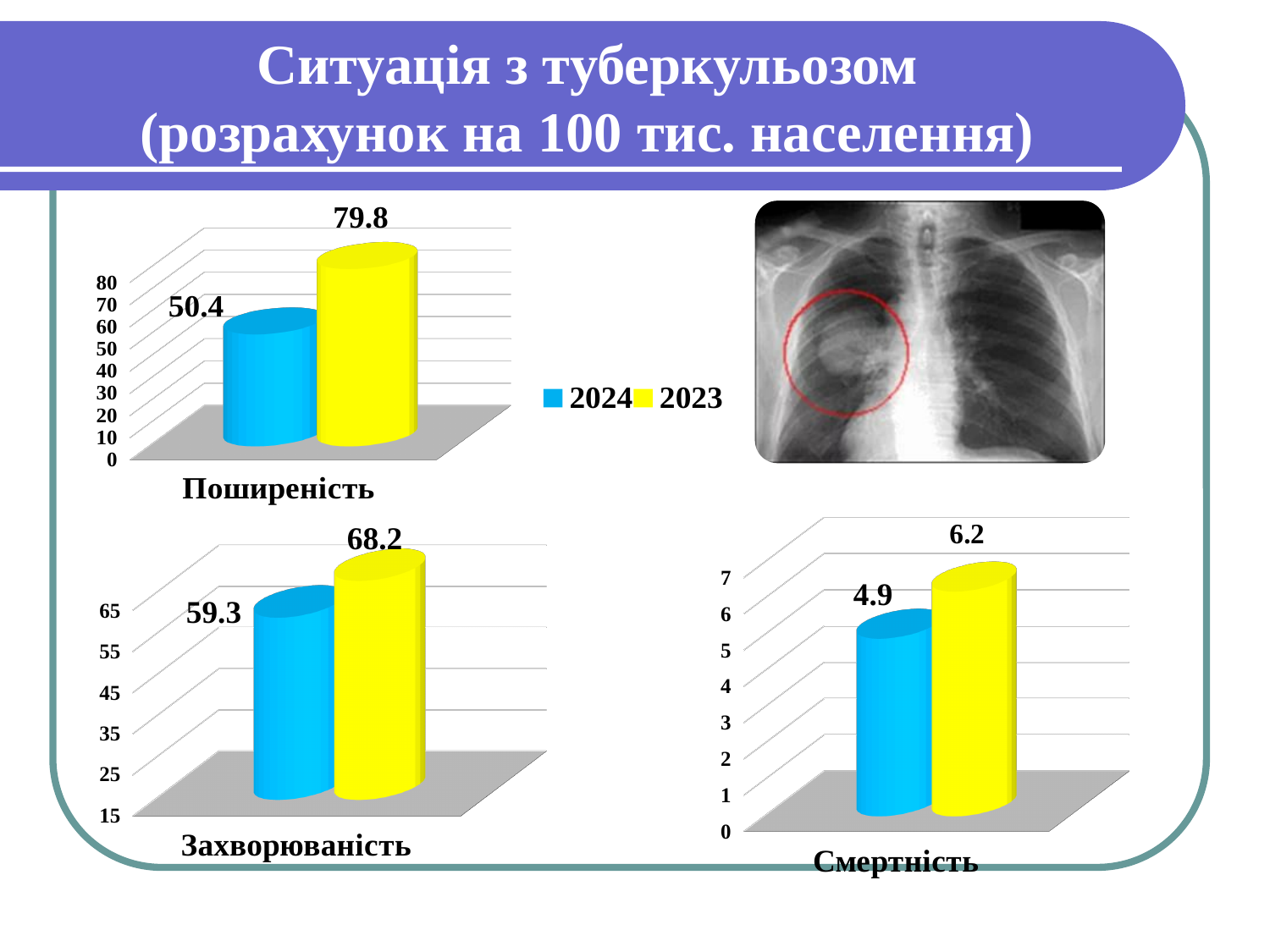
In the Захворюваність chart, what is the value for 2023? 68.2 In the Захворюваність chart, which year has the lower value? 2024 In the Смертність chart, which year has the higher value, 2024 or 2023? 2023 In the Поширеність chart, what is the value for 2023? 79.8 In the Поширеність chart, what is the value for 2024? 50.4 In the Смертність chart, what is the value for 2023? 6.2 In the Смертність chart, what is the value for 2024? 4.9 In the Поширеність chart, what is the difference between the 2023 and 2024 values? 29.4 In the Поширеність chart, is the value for 2024 greater or less than 60? less What kind of chart is the Смертність chart? bar chart How many series does the legend on the slide list? 2 In the Захворюваність chart, what is the difference between the 2023 and 2024 values? 8.9